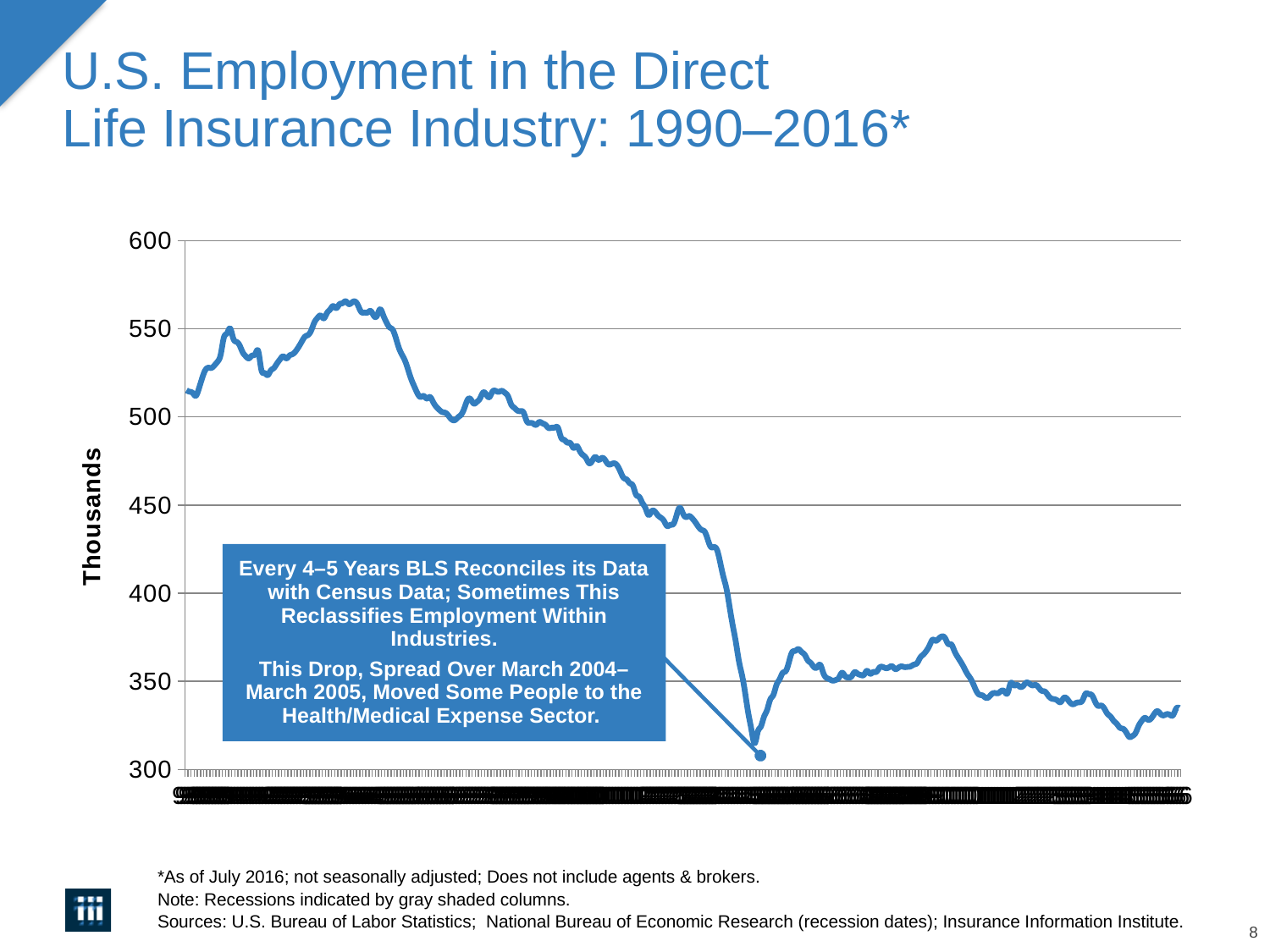
What is the title of the chart? U.S. Employment in the Direct Life Insurance Industry: 1990–2016* What kind of chart is shown on the slide? Line chart How many lines are plotted on the chart? 1 Is the value at the far right end of the line greater or less than 350? less What is the highest value shown on the vertical axis? 600 Which is larger: the value at the start of the line on the left or the value at the end of the line on the right? The value at the start on the left Is the lowest point on the line greater or less than 350? less What is the label on the vertical axis of the chart? Thousands Is the value at the far left start of the line greater or less than 500? greater Overall, do the values on the line rise or fall from the left of the chart to the right? Fall